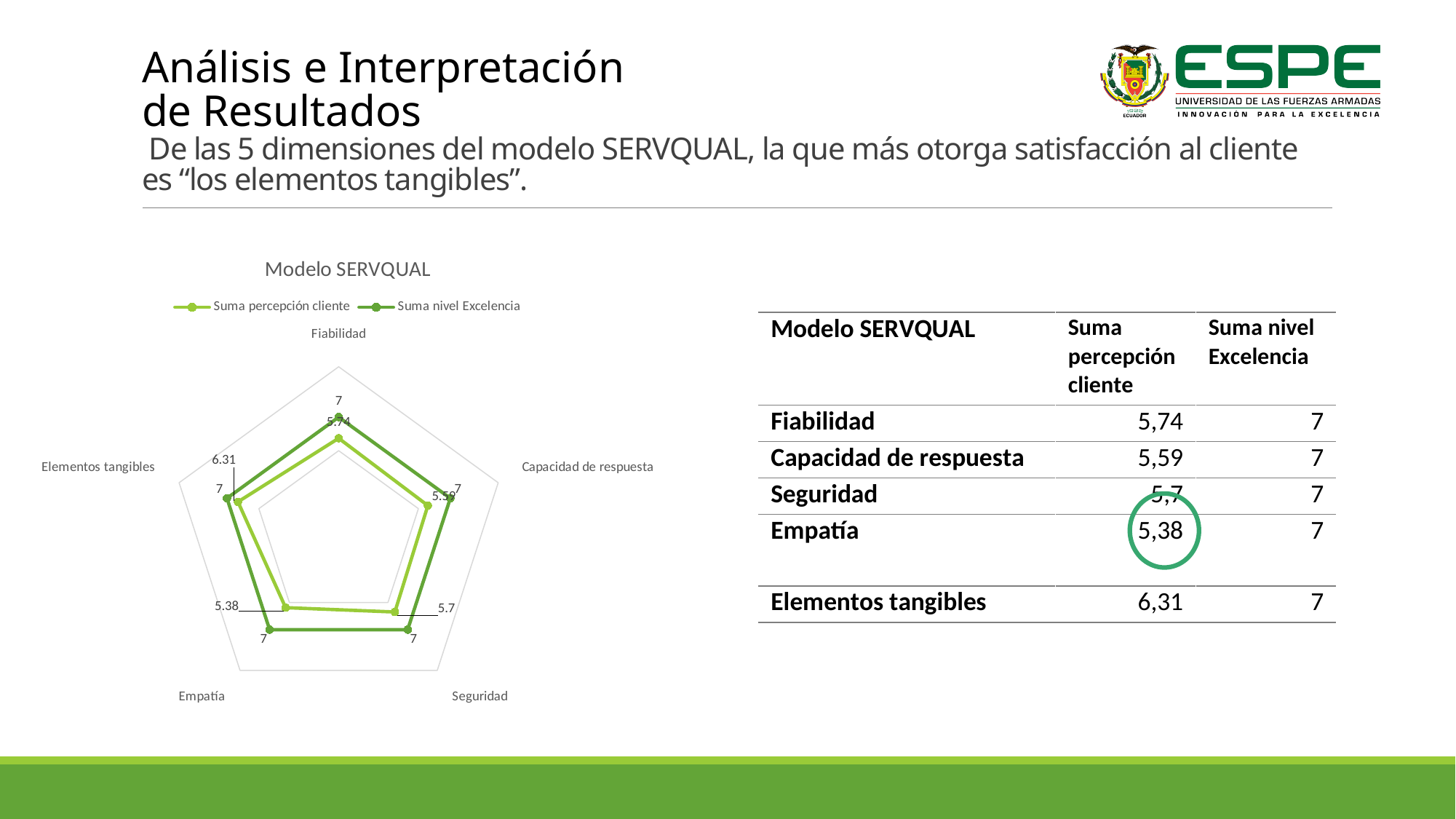
Which category has the highest Suma percepción cliente value? Elementos tangibles Which category has the lowest Suma percepción cliente value? Empatía How many categories (dimensions) are plotted on the radar chart? 5 What is the Suma nivel Excelencia value for Seguridad? 7 What is the difference between the Suma nivel Excelencia and Suma percepción cliente values for Capacidad de respuesta? 1.41 What is the Suma percepción cliente value for Elementos tangibles? 6.31 What kind of chart is shown on the slide? Radar chart How many series does the chart legend list? 2 What is the Suma percepción cliente value for Fiabilidad? 5.74 What is the Suma percepción cliente value for Empatía? 5.38 What is the title of the chart? Modelo SERVQUAL Which is larger for Seguridad: the Suma percepción cliente value or the Suma nivel Excelencia value? Suma nivel Excelencia